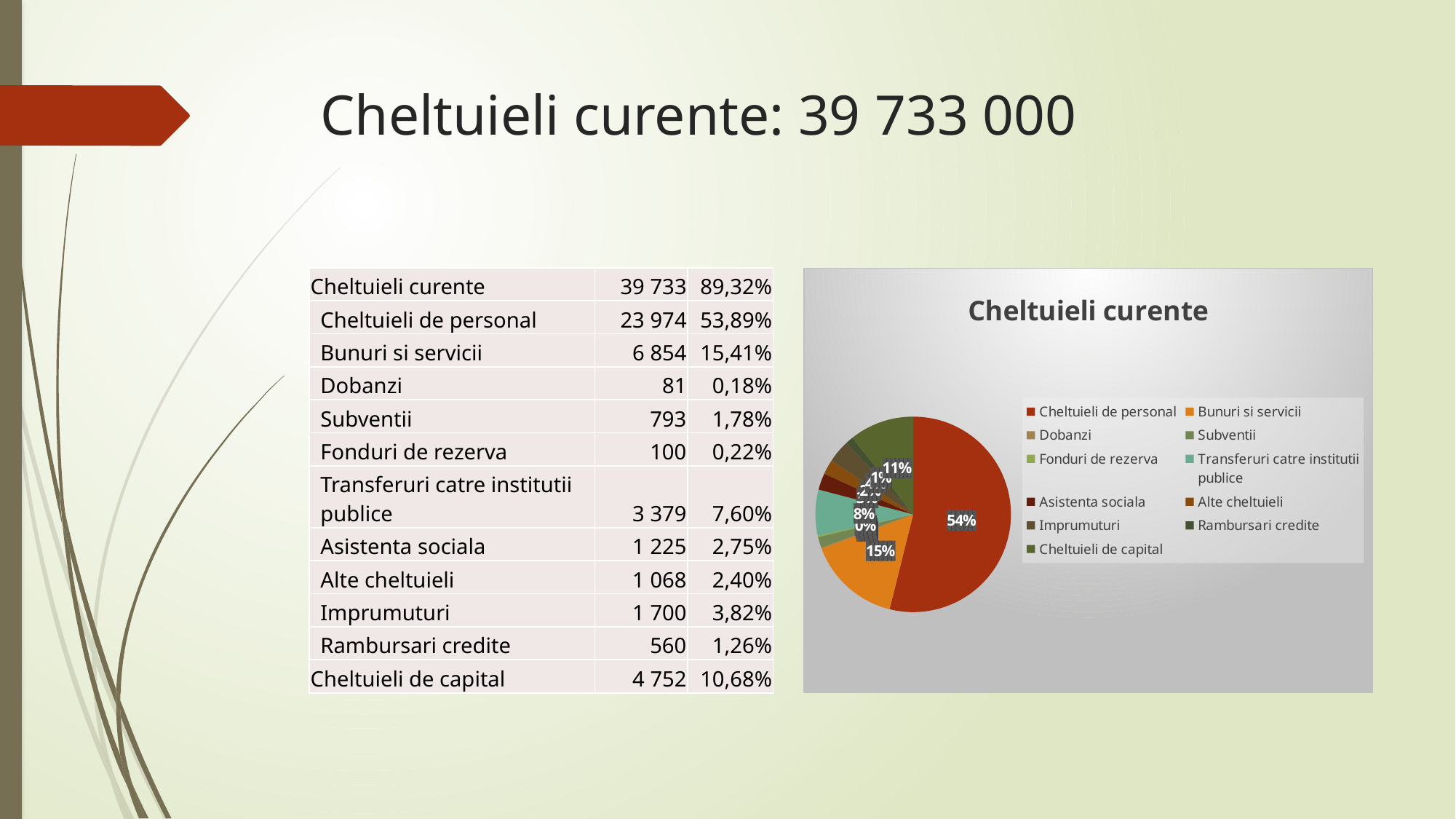
What share of the pie does Cheltuieli de capital have? 11% Which is larger in the pie chart, Cheltuieli de personal or Bunuri si servicii? Cheltuieli de personal What is the title of the chart? Cheltuieli curente Which category has the largest slice of the pie? Cheltuieli de personal What is the difference in percentage points between the Cheltuieli de personal slice and the Bunuri si servicii slice? 39% Which is larger in the pie chart, Bunuri si servicii or Cheltuieli de capital? Bunuri si servicii What kind of chart is shown on the slide? pie chart What share of the pie does Cheltuieli de personal have? 54% What colour is the largest slice of the pie? red What share of the pie does Transferuri catre institutii publice have? 8% How many entries does the chart's legend list? 11